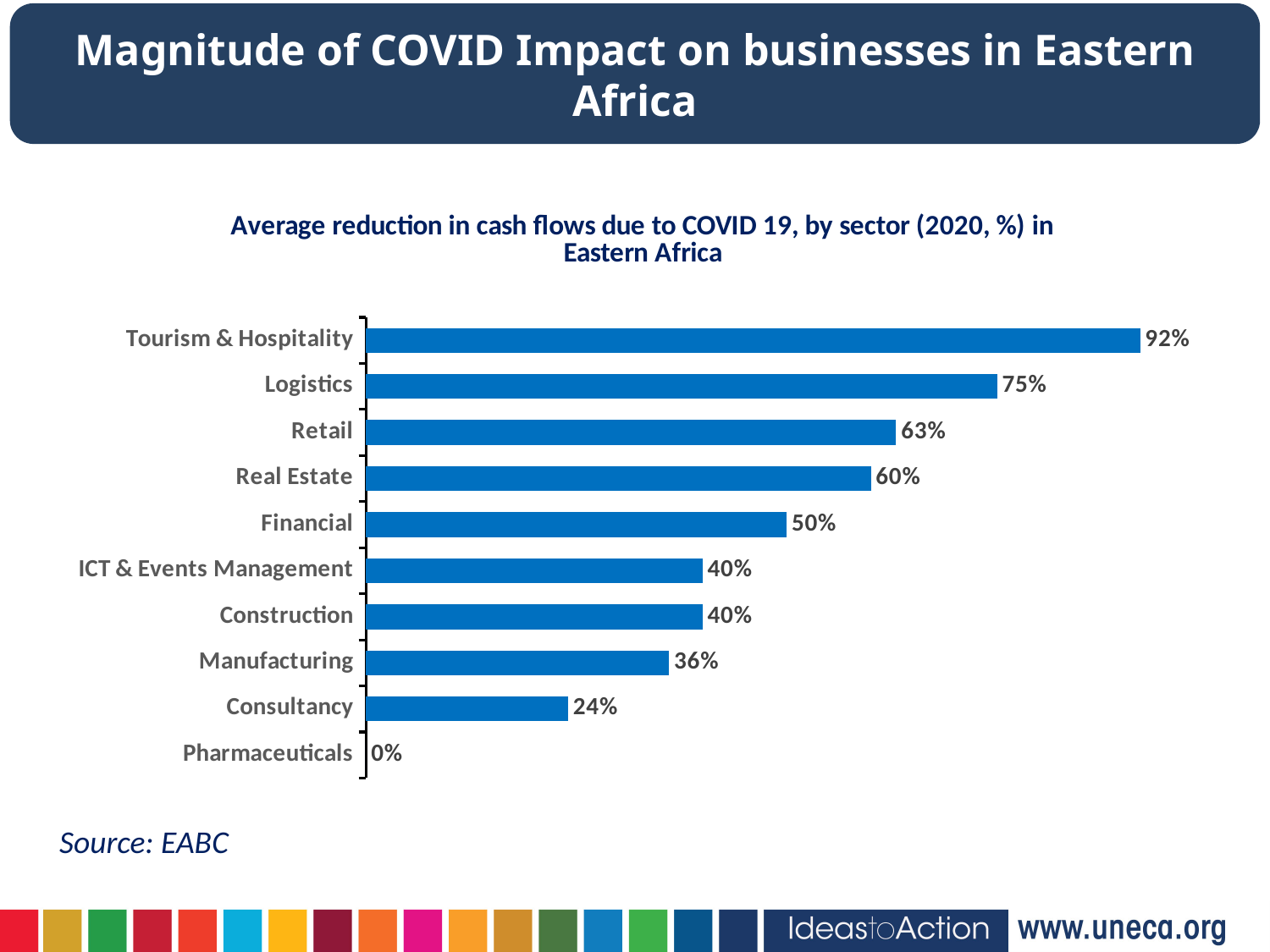
How many sectors are shown in the chart? 10 Which has a larger value, Retail or Financial? Retail What is the value shown for Manufacturing? 36% Which sector has the lowest average reduction in cash flows? Pharmaceuticals What is the average reduction in cash flows for Tourism & Hospitality? 92% What is the value shown for Consultancy? 24% Which two sectors share the same value of 40%? ICT & Events Management and Construction What is the difference between the values for Real Estate and Financial? 10% What is the difference between the values for Logistics and Retail? 12% Which sector has the highest average reduction in cash flows? Tourism & Hospitality What is the source cited for the chart? EABC What type of chart is shown on the slide? Bar chart